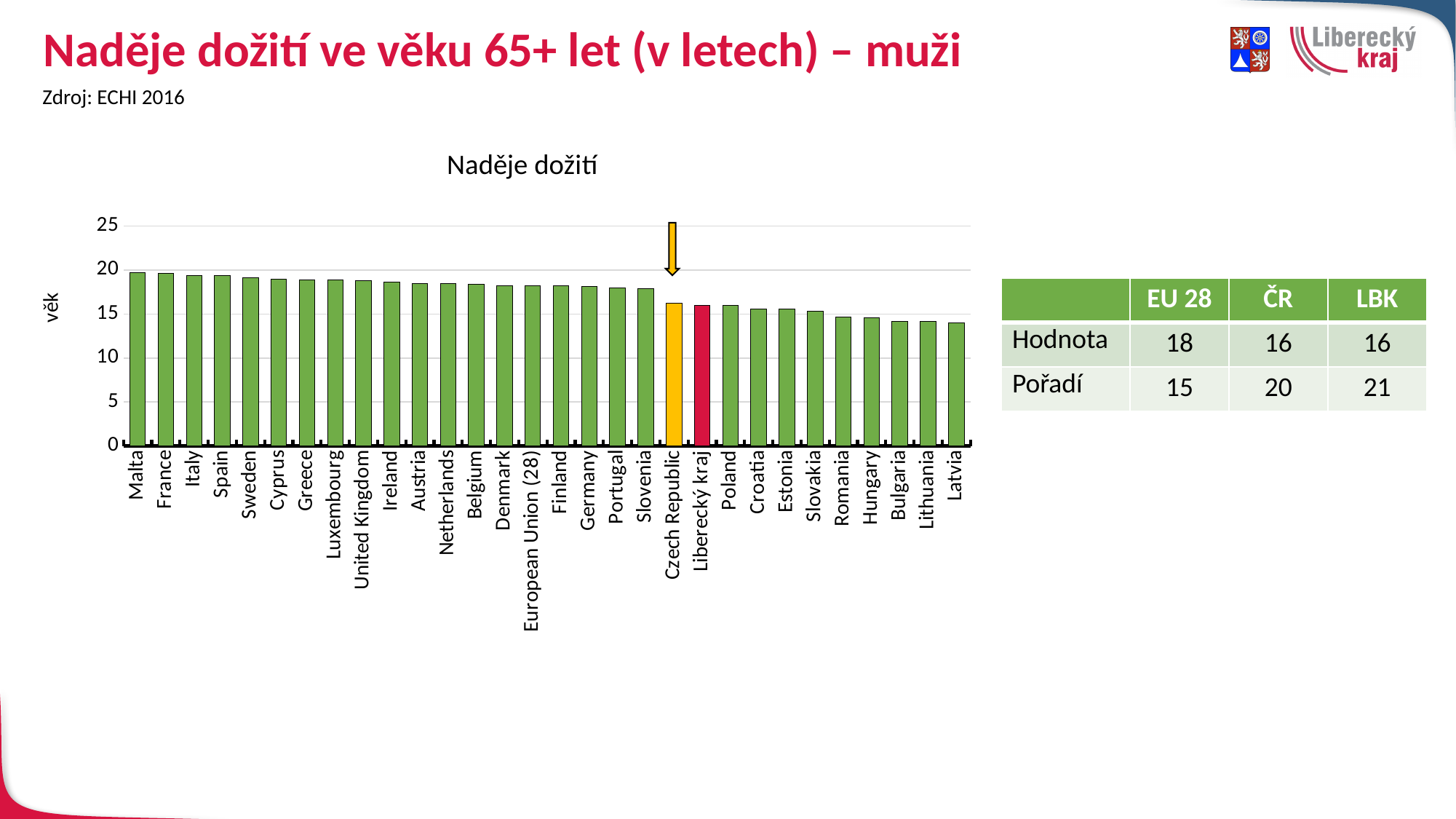
Is the value for France greater or less than 10? greater What is the title of the chart? Naděje dožití What is the label on the y axis of the chart? věk What kind of chart is shown on the slide? bar chart Is the value for Latvia greater or less than 15? less Which has the larger value, Malta or Latvia? Malta Which has the larger value, Germany or Poland? Germany Is the value for Malta greater or less than 15? greater Do the values rise or fall from left to right along the x axis? fall How many countries or regions are plotted on the chart? 30